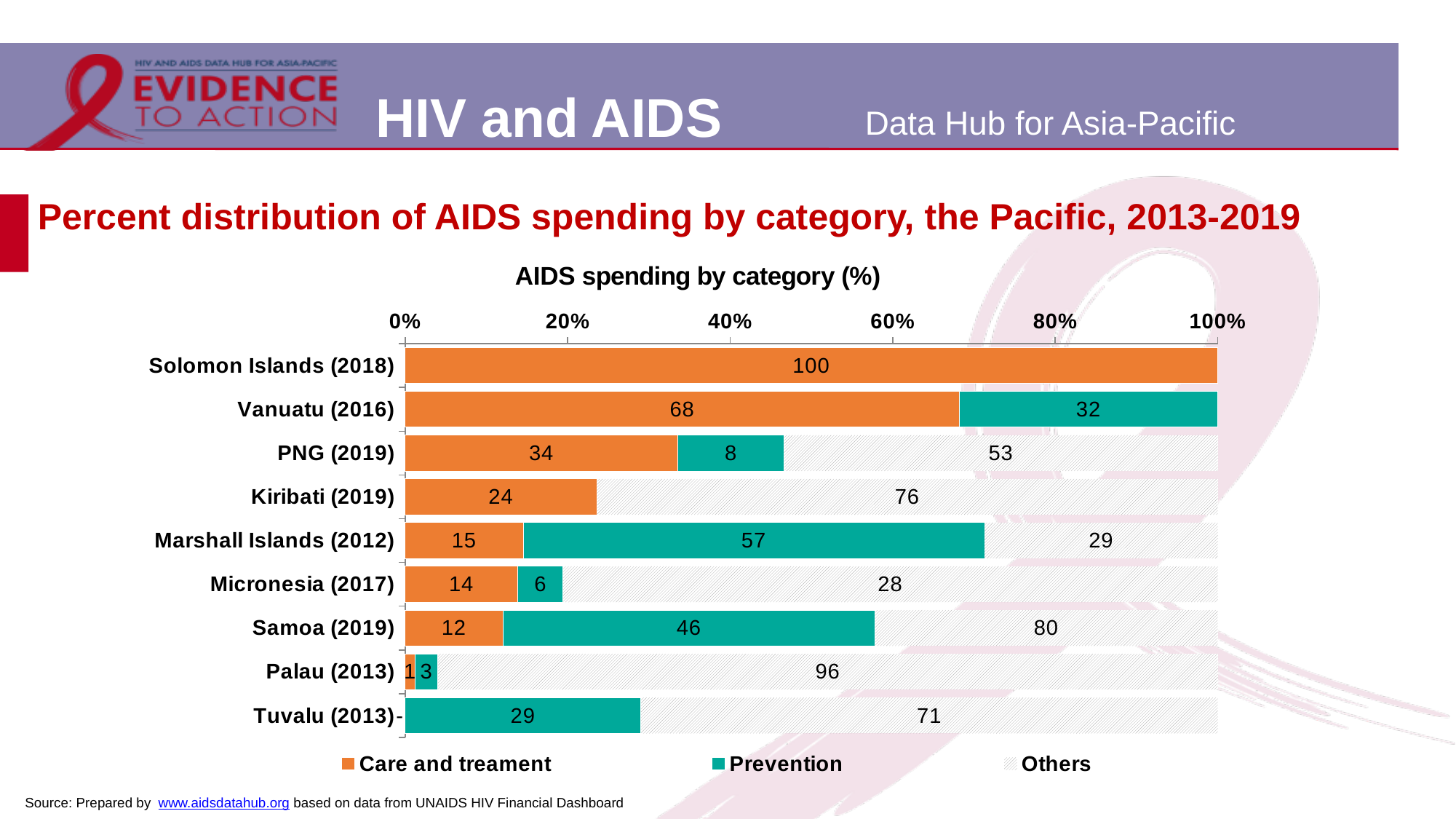
What is the difference between the Care and treatment values for PNG (2019) and Kiribati (2019)? 10 Which country has the highest Others value? Palau (2013) Which is larger, the Prevention value for Samoa (2019) or the Prevention value for Vanuatu (2016)? Samoa (2019) How many series does the legend list? 3 What is the title of the chart? AIDS spending by category (%) What is the Others value for Kiribati (2019)? 76 Which country has the highest Care and treatment value? Solomon Islands (2018) What type of chart is shown on the slide? Stacked bar chart What is the Prevention value for Marshall Islands (2012)? 57 What is the Care and treatment value for Vanuatu (2016)? 68 What is the total of the stacked bar for Tuvalu (2013)? 100 How many countries (categories) are shown in the chart? 9